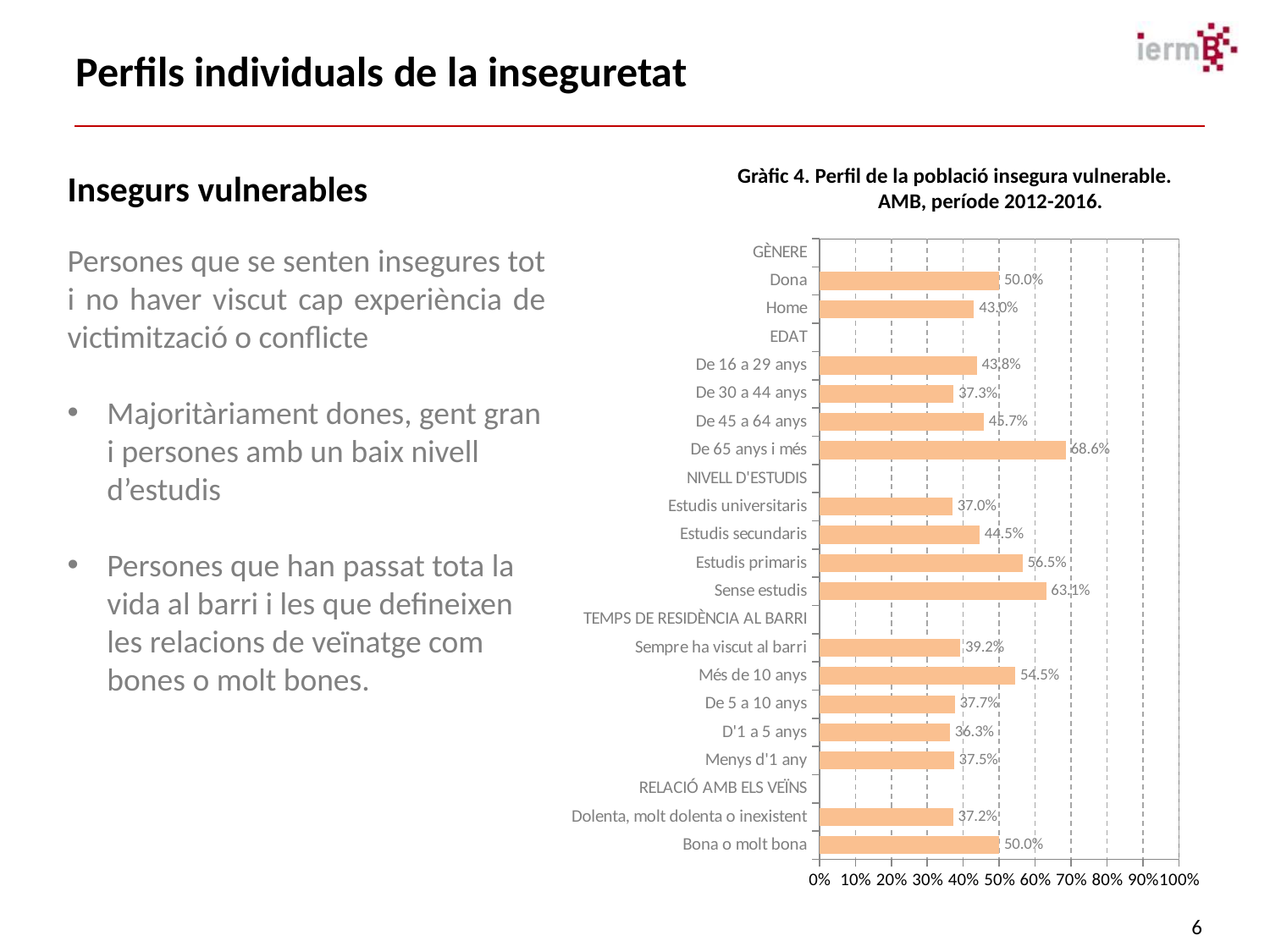
What kind of chart is shown on the slide? Bar chart Which category has the highest value in the chart? De 65 anys i més What is the value for "De 65 anys i més"? 68.6% What is the value for "Més de 10 anys"? 54.5% What is the title of the chart? Gràfic 4. Perfil de la població insegura vulnerable. AMB, període 2012-2016. What is the value for "Dona"? 50.0% What is the difference between the values for "Sense estudis" and "Estudis universitaris"? 26.1% Is the value for "Bona o molt bona" greater or less than 40%? greater What is the difference between the values for "Dona" and "Home"? 7.0% What is the value for "Sense estudis"? 63.1% Which category has the lowest value in the chart? D'1 a 5 anys Which is larger, the value for "Estudis primaris" or the value for "Estudis secundaris"? Estudis primaris